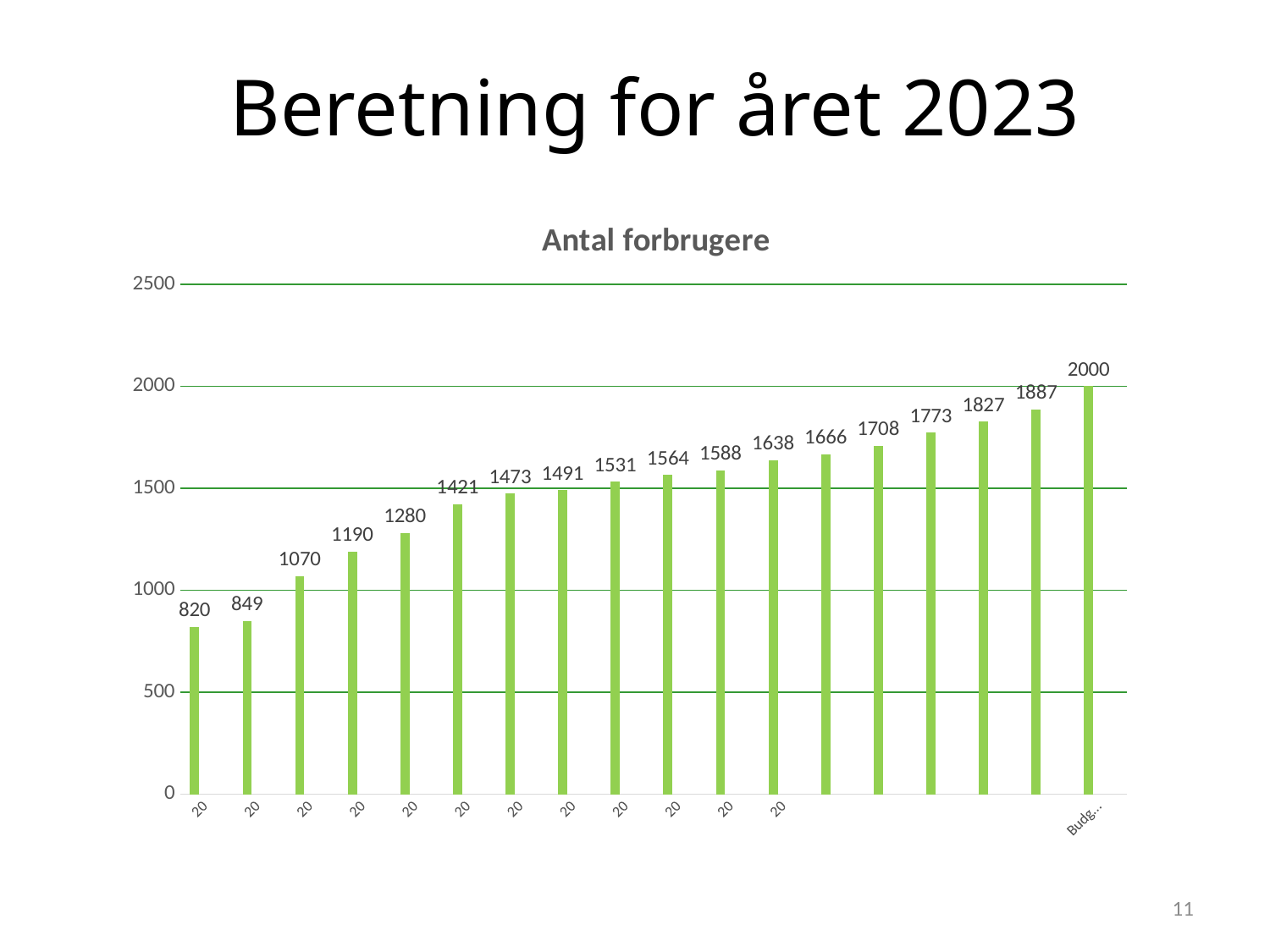
What is the lowest value shown in the chart? 820 How many bars are plotted in the chart? 18 What is the difference between the rightmost bar and the leftmost bar? 1180 What is the title of the chart? Antal forbrugere What kind of chart is shown on the slide? bar chart What is the difference between the second bar and the first bar? 29 Do the values rise or fall from left to right along the x axis? rise What is the highest value shown in the chart? 2000 Is the value of the first bar greater or less than 1000? less What is the value of the first (leftmost) bar in the chart? 820 What is the value of the second bar from the left? 849 What is the value of the last (rightmost) bar in the chart? 2000